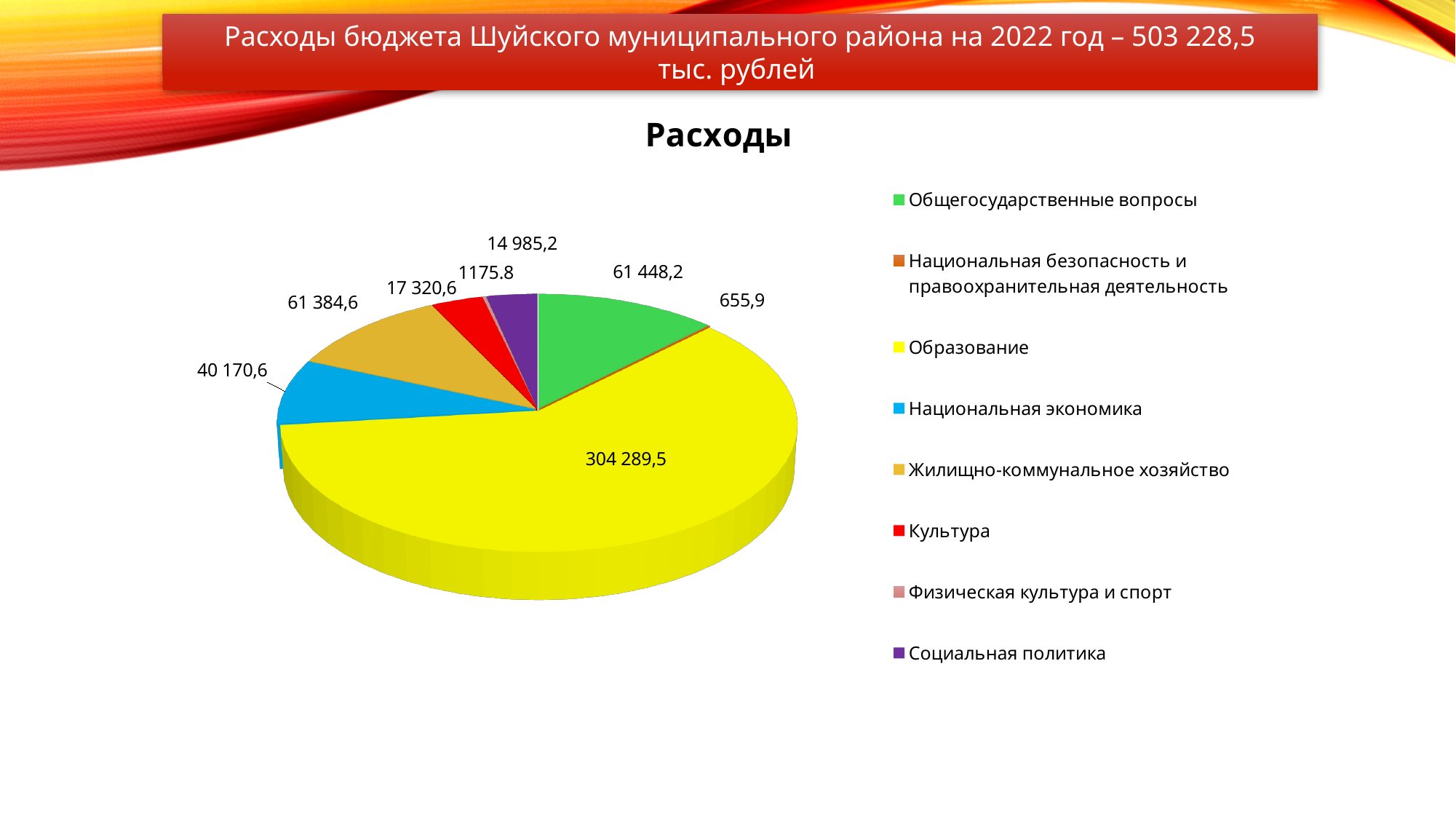
Which category has the largest slice of the pie? Образование What is the title of the chart? Расходы How many categories does the pie chart show? 8 What is the difference between Национальная экономика and Культура? 22 850,0 Which category has the smallest value in the pie chart? Национальная безопасность и правоохранительная деятельность What is the value for Образование in the pie chart? 304 289,5 What is the value for Социальная политика? 14 985,2 Which is larger: Национальная экономика or Культура? Национальная экономика What is the value for Национальная безопасность и правоохранительная деятельность? 655,9 What is the value for Национальная экономика? 40 170,6 What type of chart is shown on the slide? Pie chart What is the value for Культура? 17 320,6